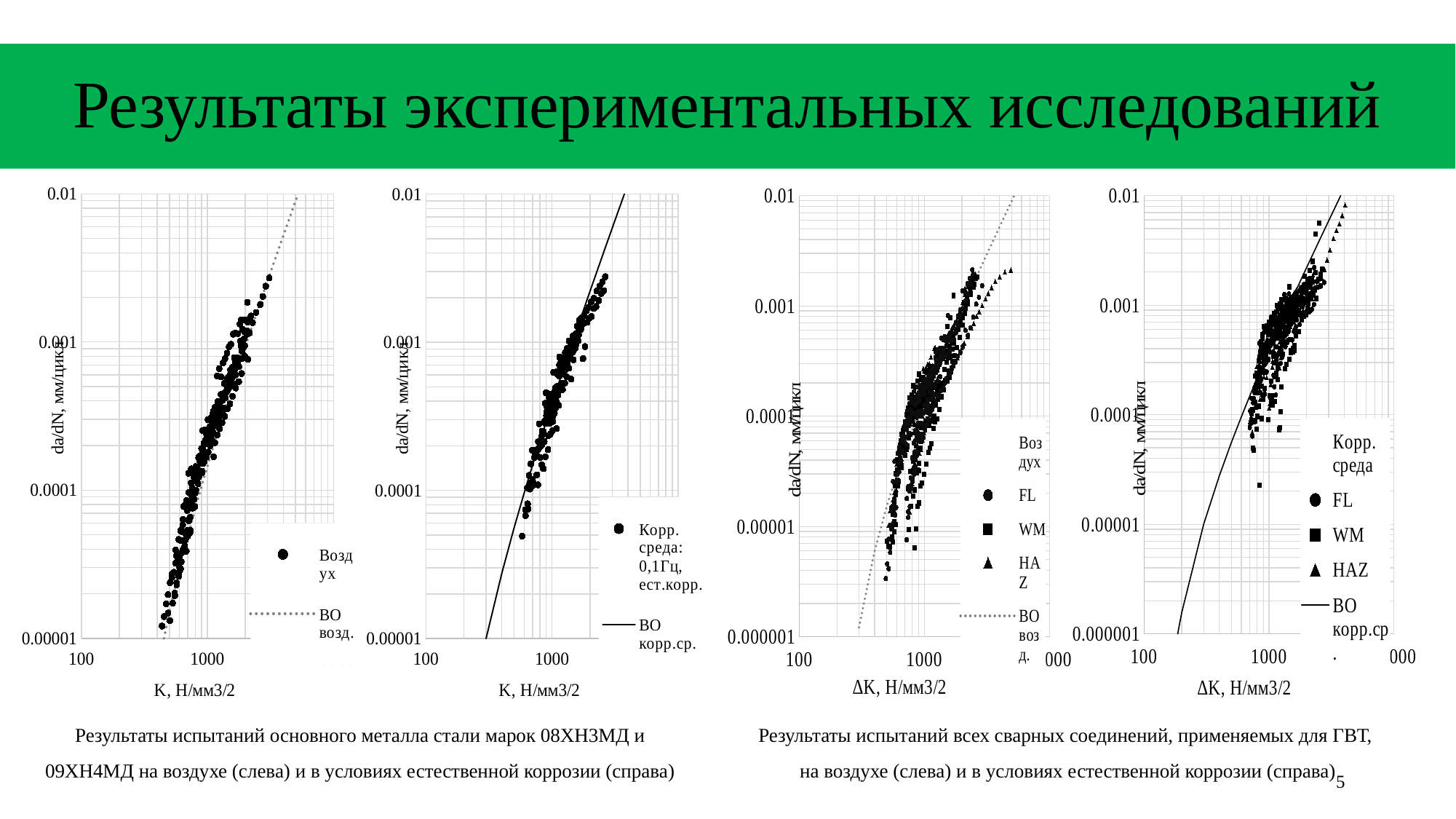
In the rightmost chart, what marker shape is used for the HAZ series? triangle In the third chart from the left (ΔK, воздух), how many entries does the legend list? 5 In the rightmost chart, which legend entries are plotted as markers rather than a line? FL, WM, HAZ In the leftmost chart, is the lowest plotted da/dN value greater or less than 0.0001? less In the third chart from the left, is the highest plotted da/dN value greater or less than 0.001? greater In the rightmost chart, is the lowest plotted da/dN value greater or less than 0.0001? less In the second chart from the left, do the plotted da/dN values rise or fall as K increases? rise In the leftmost chart, do the plotted da/dN values rise or fall as K increases? rise How many charts are shown on the slide? 4 What kind of chart is the leftmost chart on the slide? scatter chart In the leftmost chart, how many entries does the legend list? 2